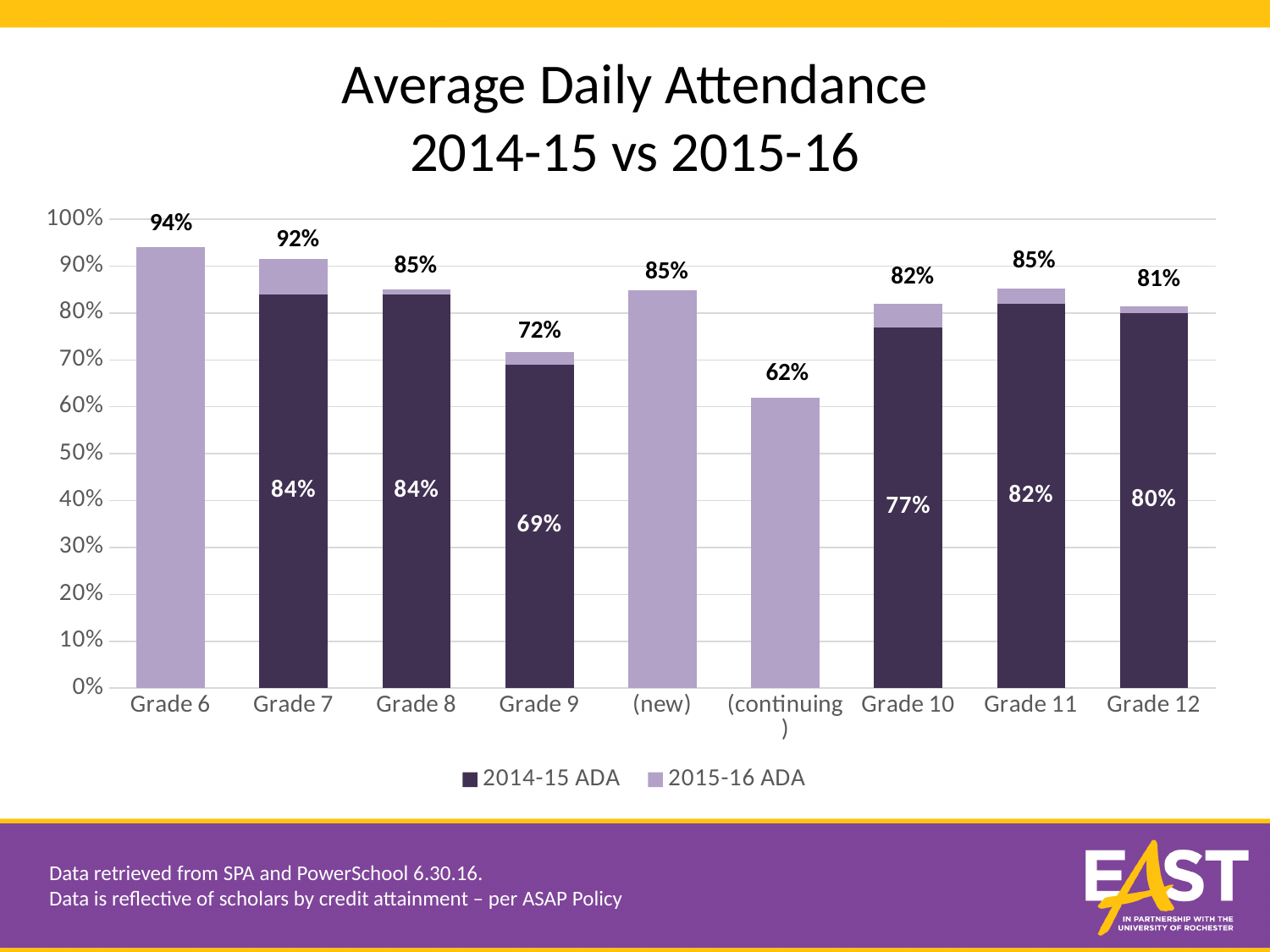
Which category has the lowest 2015-16 ADA? (continuing) How many series does the legend list? 2 Which is larger, the 2015-16 ADA for Grade 9 or the 2015-16 ADA for (continuing)? Grade 9 Which category has the highest 2015-16 ADA? Grade 6 What is the difference between the 2015-16 ADA and the 2014-15 ADA for Grade 7? 8% What is the 2015-16 ADA for Grade 6? 94% What is the difference between the 2015-16 ADA and the 2014-15 ADA for Grade 10? 5% What is the 2014-15 ADA for Grade 11? 82% Which category has the lowest 2014-15 ADA? Grade 9 What kind of chart is shown on the slide? Bar chart What is the 2014-15 ADA for Grade 9? 69% What is the 2015-16 ADA for Grade 10? 82%